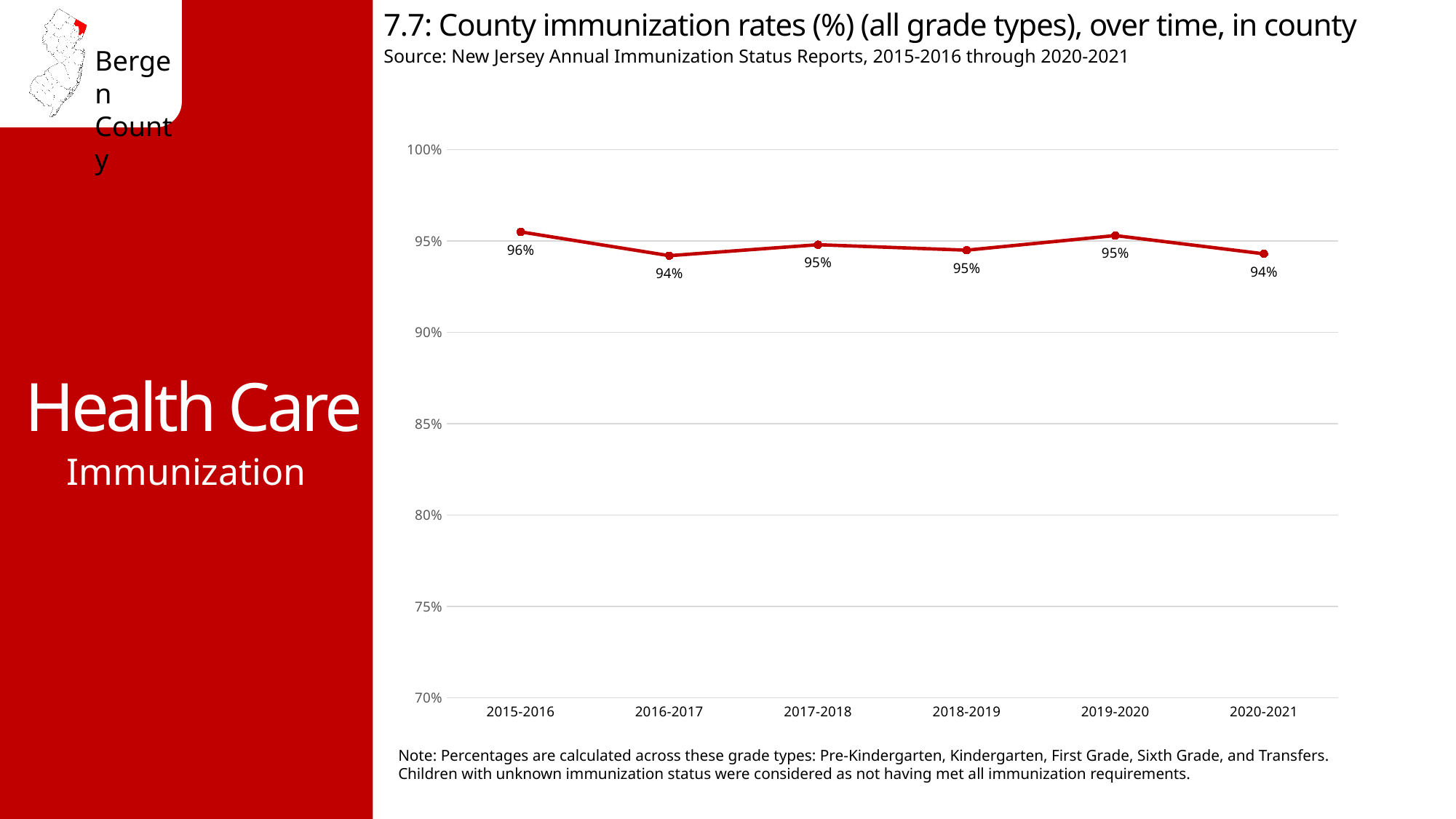
What was the county immunization rate in 2016-2017? 94% What was the county immunization rate in 2018-2019? 95% What was the county immunization rate in 2015-2016? 96% What type of chart is shown on the slide? Line chart What is the difference in percentage points between the immunization rate in 2015-2016 and in 2020-2021? 2 percentage points Did the county immunization rate rise or fall overall from 2015-2016 to 2020-2021? Fall Which school year had the highest county immunization rate? 2015-2016 Is the immunization rate for 2017-2018 greater or less than 90%? greater Which year had a higher immunization rate, 2015-2016 or 2016-2017? 2015-2016 What is the source cited for the chart data? New Jersey Annual Immunization Status Reports, 2015-2016 through 2020-2021 What was the county immunization rate in 2020-2021? 94% How many school years are plotted on the chart? 6